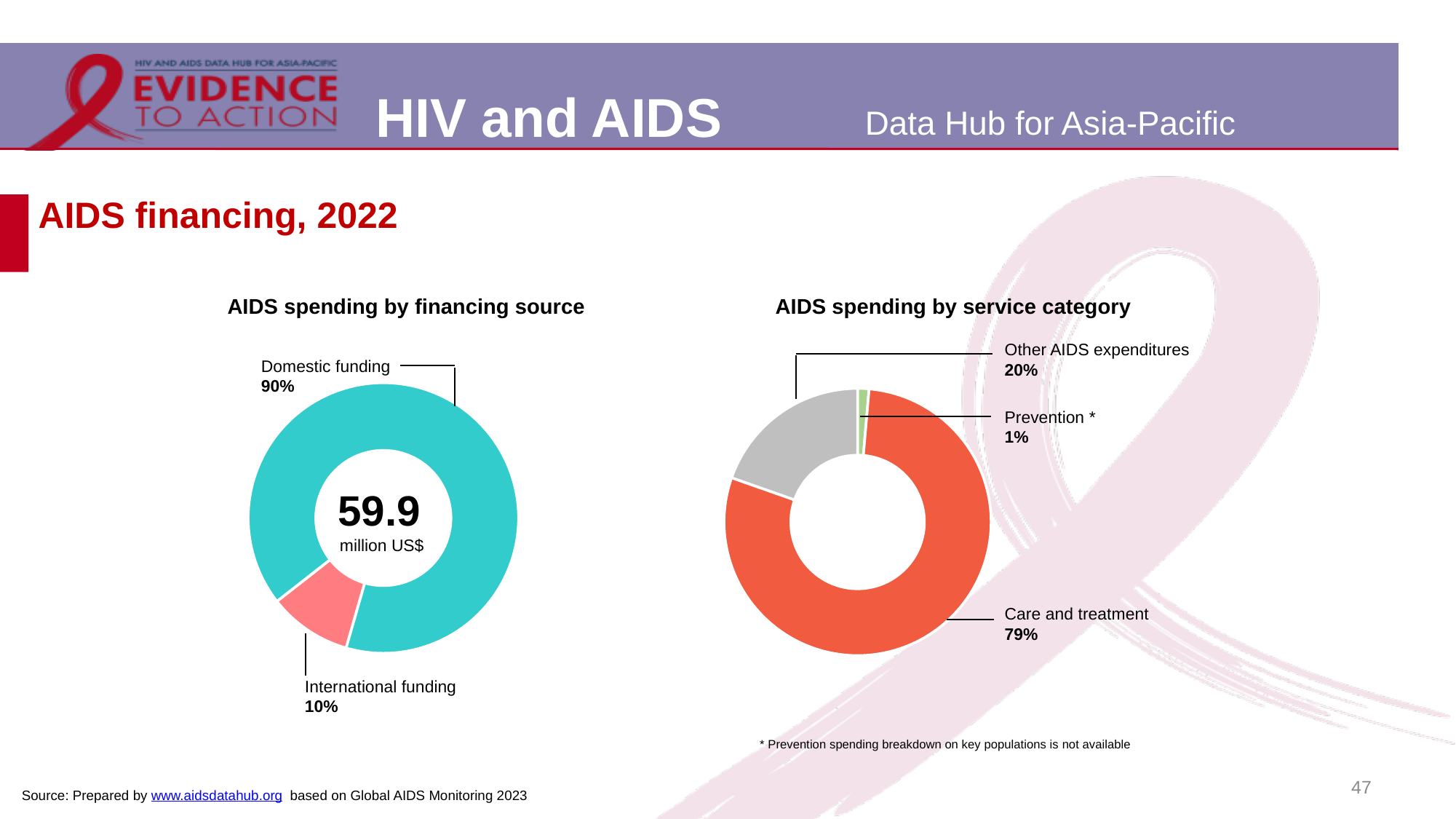
In the 'AIDS spending by financing source' chart, what share is Domestic funding? 90% In the 'AIDS spending by financing source' chart, what is the difference in percentage points between Domestic funding and International funding? 80 percentage points In the 'AIDS spending by financing source' chart, what share is International funding? 10% In the 'AIDS spending by financing source' chart, what total amount is shown in the centre of the donut? 59.9 million US$ In the 'AIDS spending by service category' chart, how many categories are shown? 3 In the 'AIDS spending by service category' chart, what share is Prevention? 1% In the 'AIDS spending by service category' chart, which category has the smallest share? Prevention In the 'AIDS spending by service category' chart, which category has the largest share? Care and treatment What type of chart is the 'AIDS spending by financing source' chart? Donut (pie) chart In the 'AIDS spending by service category' chart, which is larger: Other AIDS expenditures or Prevention? Other AIDS expenditures